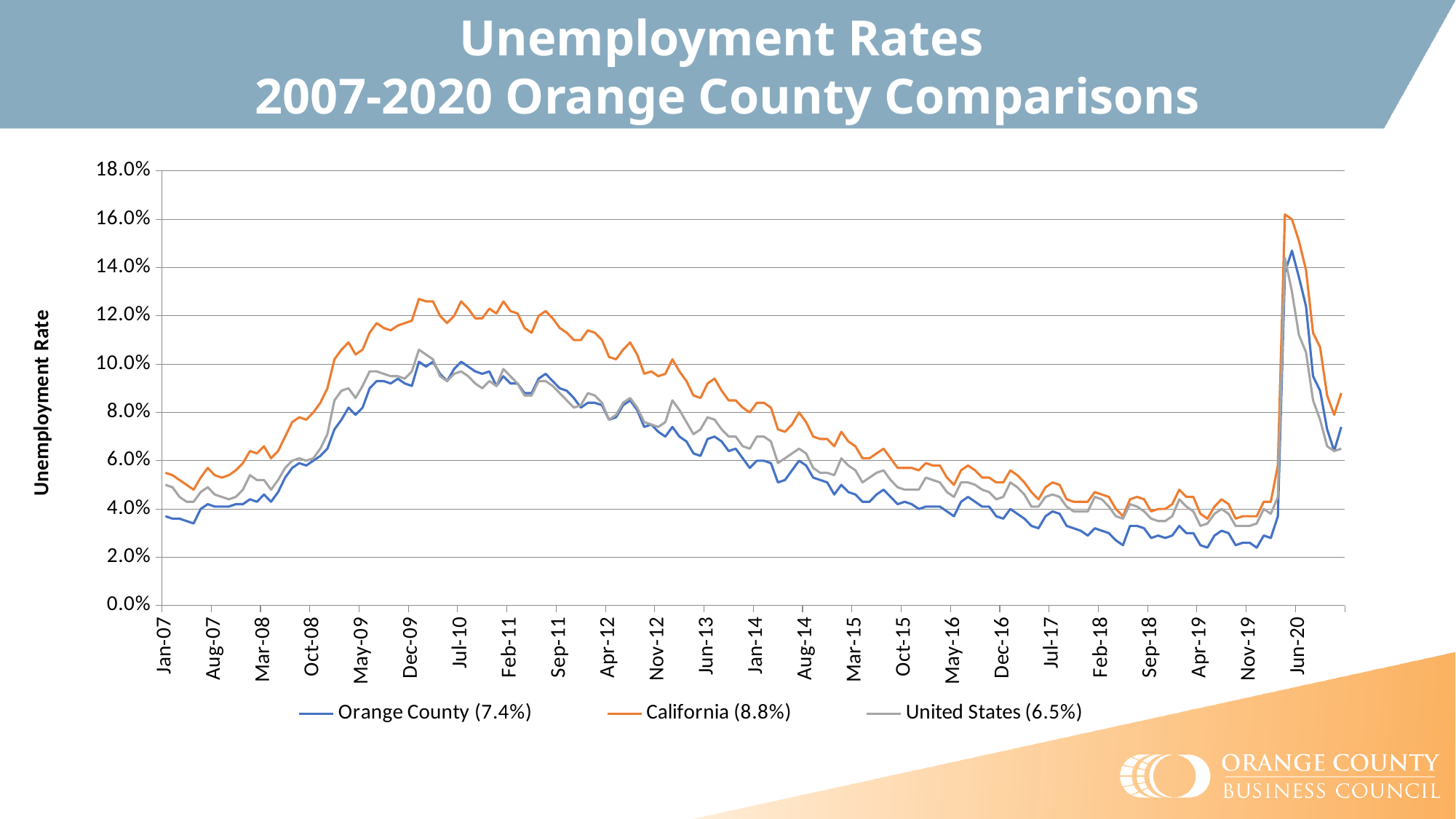
What value is shown in parentheses in the legend for California? 8.8% What is the label on the vertical axis? Unemployment Rate Which series has the lowest values during 2019? Orange County At Jan-07, which is higher: California or Orange County? California How many series does the legend list? 3 Is the peak value for Orange County in 2020 greater or less than 14.0%? greater Is the value for Orange County at Jan-07 greater or less than 4.0%? less What value is shown in parentheses in the legend for Orange County? 7.4% What value is shown in parentheses in the legend for United States? 6.5% What kind of chart is shown on the slide? line chart Which series reaches the highest peak on the chart? California Does the Orange County unemployment rate rise or fall from Jul-10 to Nov-19? fall